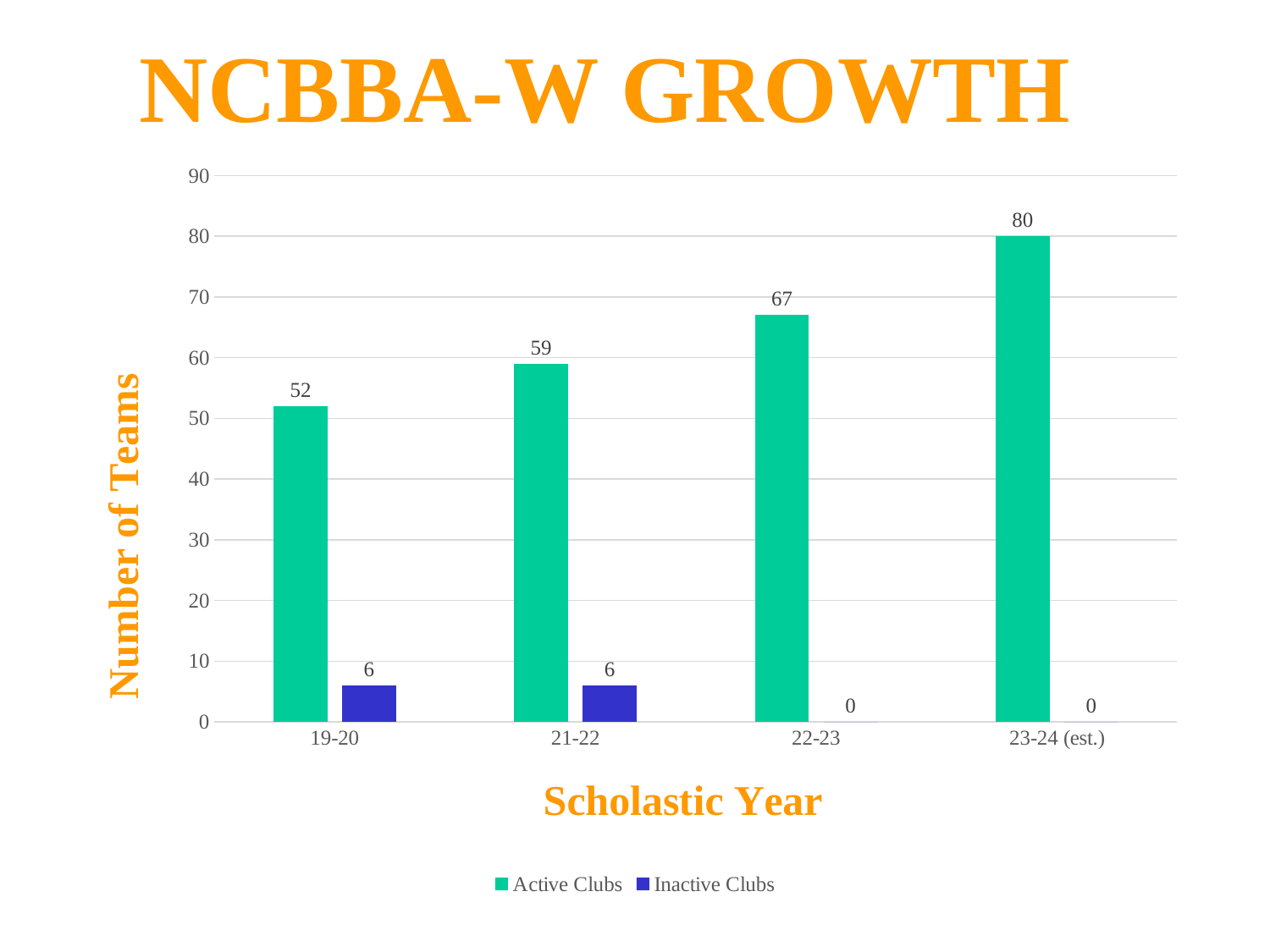
Do the Active Clubs values rise or fall across the scholastic years? Rise How many Inactive Clubs were there in 22-23? 0 How many scholastic years are shown on the x axis? 4 Which scholastic year has the lowest number of Active Clubs? 19-20 What kind of chart is shown on the slide? Bar chart What is the difference in Active Clubs between 22-23 and 21-22? 8 What is the estimated number of Active Clubs for 23-24 (est.)? 80 How many Inactive Clubs were there in 21-22? 6 How many Active Clubs were there in 19-20? 52 Which scholastic year has the highest number of Active Clubs? 23-24 (est.) How many series does the legend list? 2 Which is larger, the number of Active Clubs in 21-22 or in 22-23? 22-23